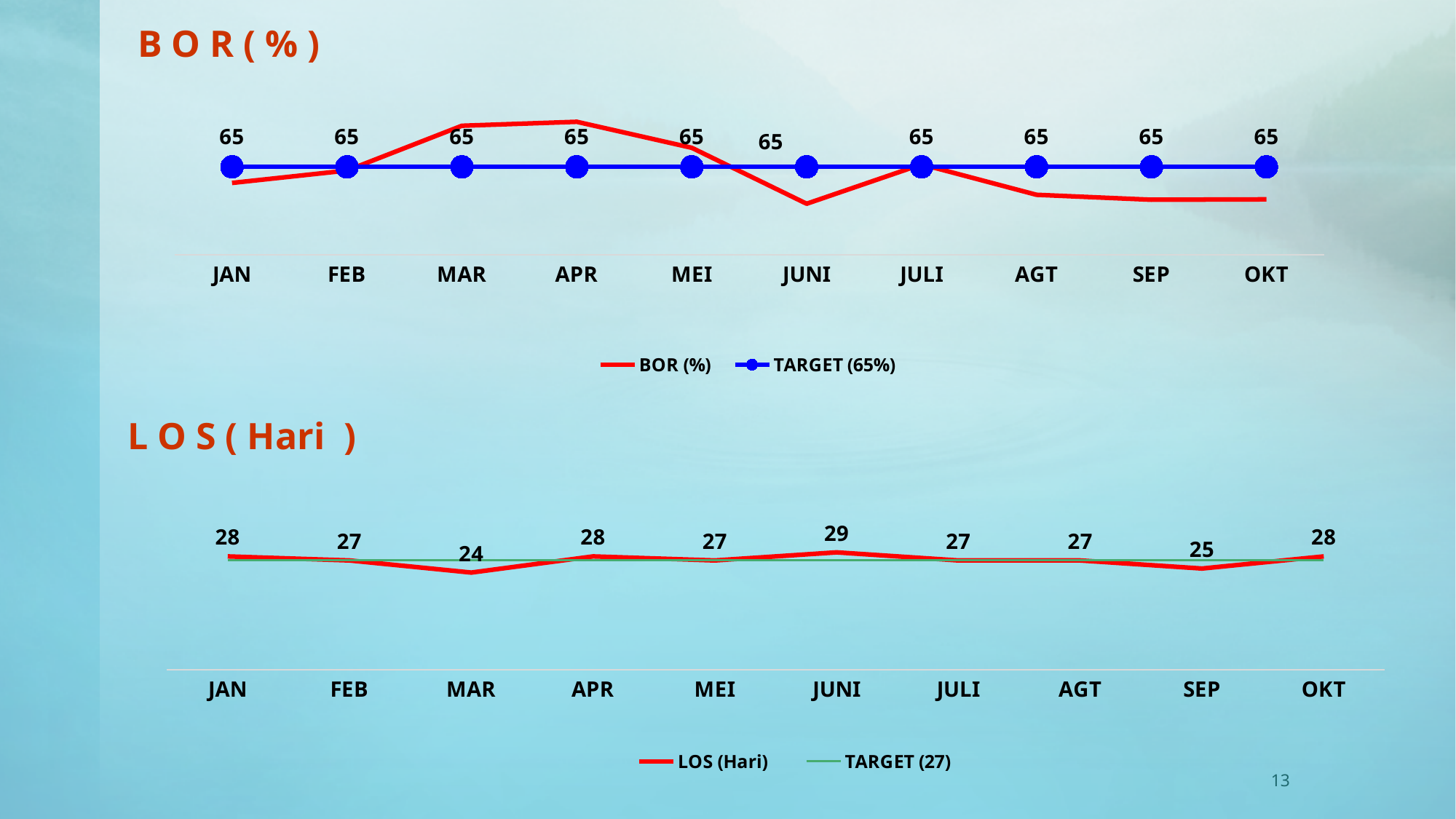
In the BOR (%) chart, is the BOR value for APR above or below the TARGET line? above What type of chart is the BOR (%) chart? line chart In the LOS (Hari) chart, is the LOS value for APR larger or smaller than the value for SEP? larger In the LOS (Hari) chart, what is the LOS value for MAR? 24 In the LOS (Hari) chart, what is the difference between the LOS values for JUNI and MAR? 5 In the LOS (Hari) chart, which month has the highest LOS value? JUNI In the LOS (Hari) chart, what is the LOS value for JUNI? 29 In the BOR (%) chart, what is the TARGET value shown for MEI? 65 In the LOS (Hari) chart, which month has the lowest LOS value? MAR In the LOS (Hari) chart, what is the LOS value for SEP? 25 In the BOR (%) chart, how many series does the legend list? 2 In the LOS (Hari) chart, how many months are shown on the x axis? 10